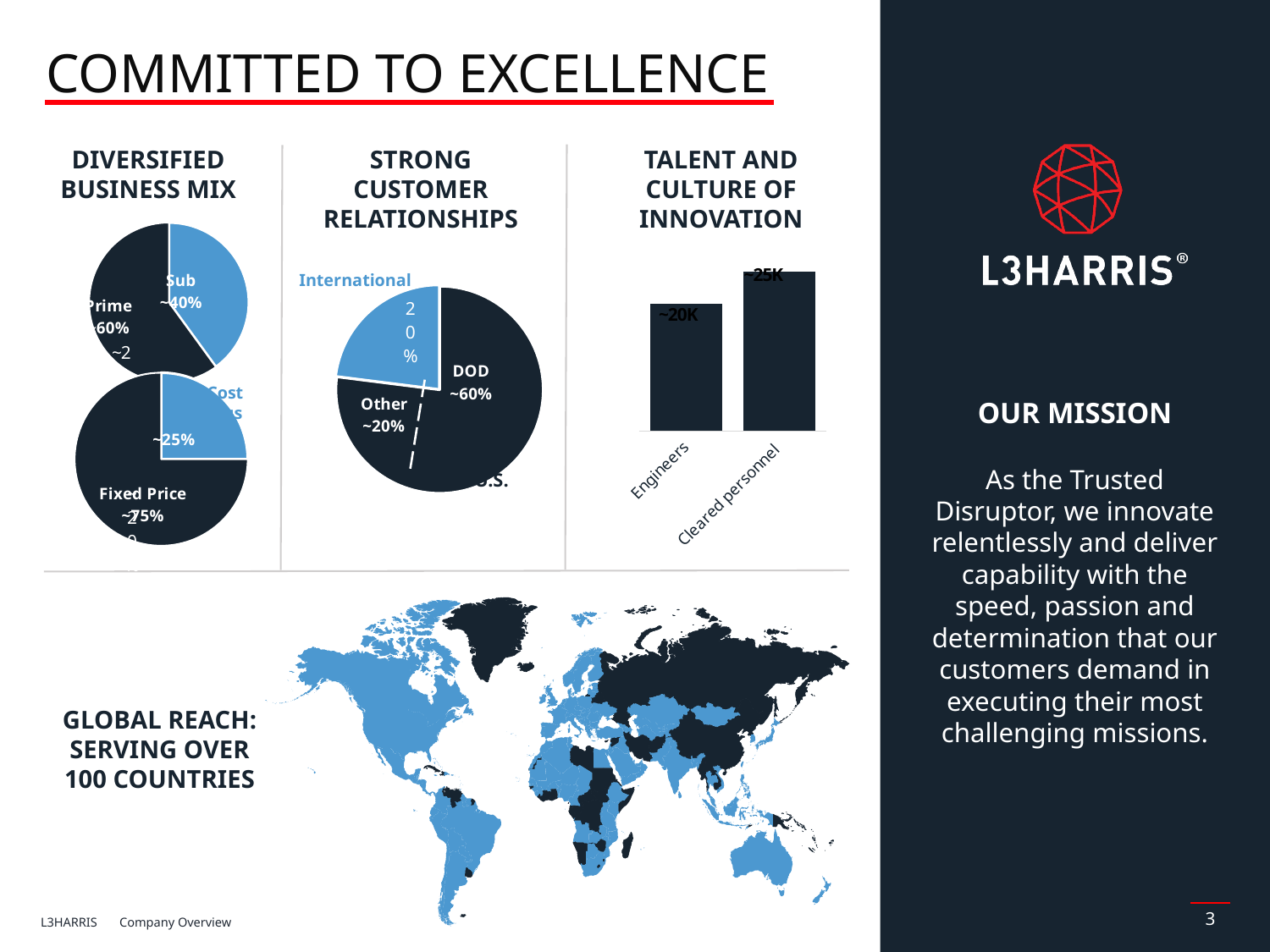
In the Strong Customer Relationships pie chart, which category has the largest slice? DOD In the Diversified Business Mix top pie chart, which is larger, Prime or Sub? Prime In the Talent and Culture of Innovation chart, which category has the taller bar? Cleared personnel In the Diversified Business Mix top pie chart, what share is labelled for Prime? ~60% In the Diversified Business Mix bottom pie chart, what share is labelled for Fixed Price? ~75% In the Diversified Business Mix top pie chart, what share is labelled for Sub? ~40% In the Talent and Culture of Innovation chart, what value is labelled for Engineers? ~20K In the Strong Customer Relationships pie chart, what share is labelled for DOD? ~60% What kind of chart is shown under Talent and Culture of Innovation? Bar chart In the Strong Customer Relationships pie chart, what share is labelled for Other? ~20% In the Talent and Culture of Innovation chart, what value is labelled for Cleared personnel? ~25K